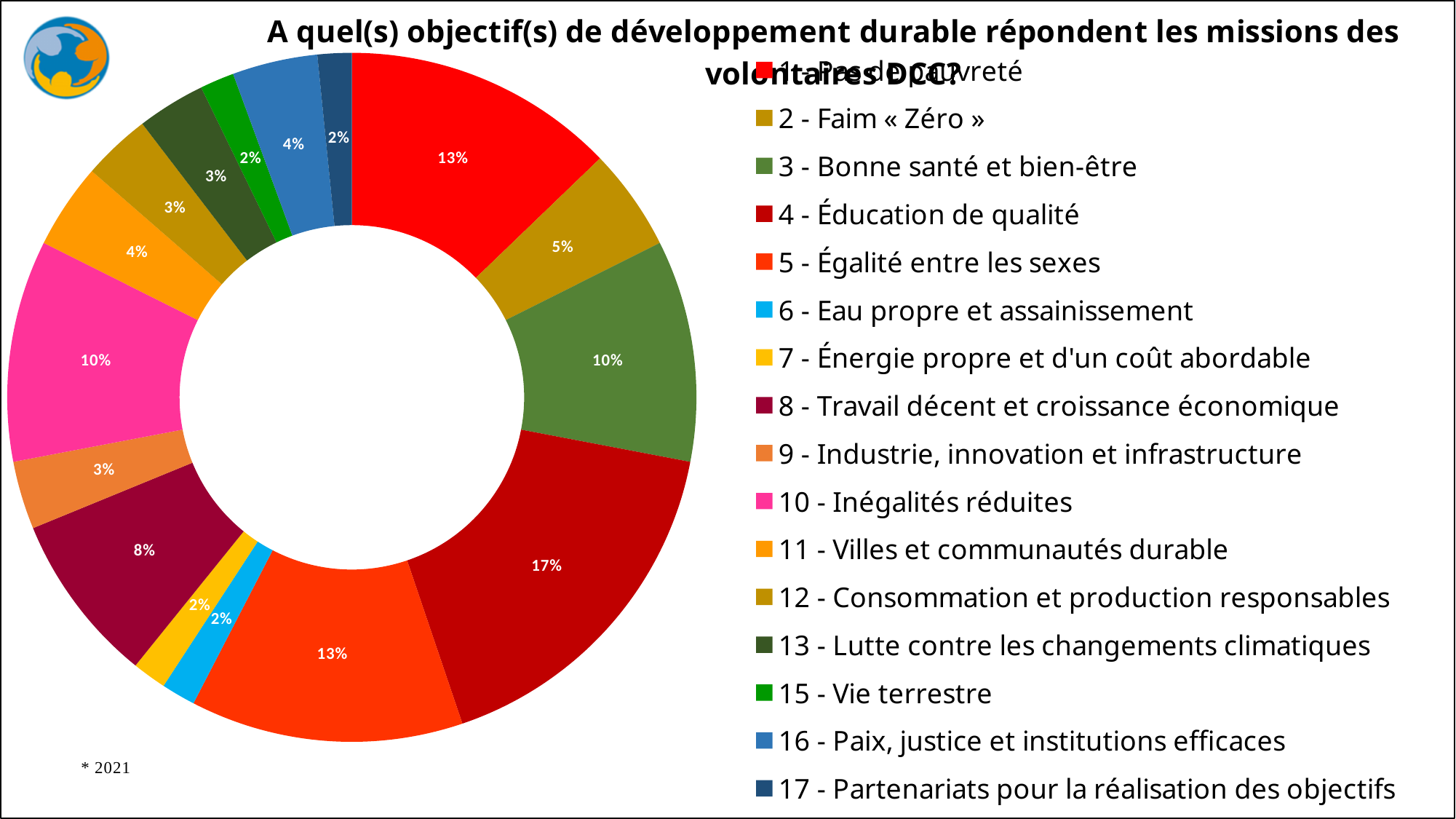
What percentage is shown for "16 - Paix, justice et institutions efficaces"? 4% What is the combined share of "1 - Pas de pauvreté" and "5 - Égalité entre les sexes"? 26% What year is indicated by the footnote at the bottom left of the chart? 2021 What is the difference in percentage points between "4 - Éducation de qualité" and "2 - Faim « Zéro »"? 12 What percentage is shown for "8 - Travail décent et croissance économique"? 8% Which sustainable development goal has the largest share of the chart? 4 - Éducation de qualité What kind of chart is shown on the slide? Doughnut (pie) chart How many slices does the doughnut chart have? 16 What percentage is shown for "10 - Inégalités réduites"? 10% Which has a larger share: "3 - Bonne santé et bien-être" or "8 - Travail décent et croissance économique"? 3 - Bonne santé et bien-être What percentage is shown for "4 - Éducation de qualité"? 17% Which has a larger share: "11 - Villes et communautés durable" or "9 - Industrie, innovation et infrastructure"? 11 - Villes et communautés durable